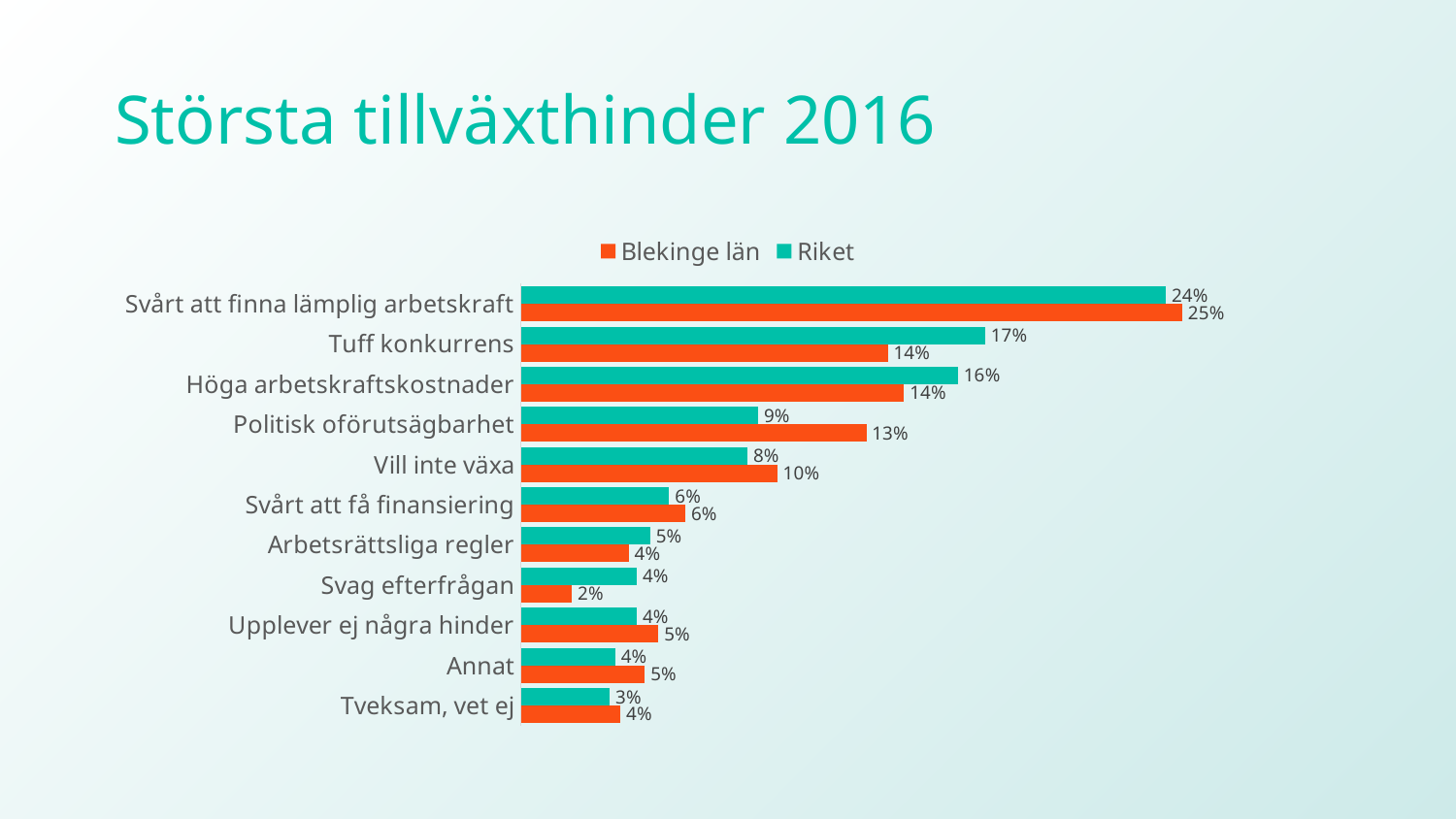
Which category has the highest value for Blekinge län? Svårt att finna lämplig arbetskraft What kind of chart is shown on the slide? bar chart Which category has the lowest value for Blekinge län? Svag efterfrågan What is the value for Riket for "Svag efterfrågan"? 4% What is the title of the chart? Största tillväxthinder 2016 How many categories are shown in the chart? 11 For "Tuff konkurrens", which series has the larger value, Blekinge län or Riket? Riket What is the value for Riket for "Tuff konkurrens"? 17% What is the value for Blekinge län for "Svårt att finna lämplig arbetskraft"? 25% What is the difference between the Riket and Blekinge län values for "Politisk oförutsägbarhet"? 4% What is the value for Blekinge län for "Politisk oförutsägbarhet"? 13% How many series does the legend list? 2